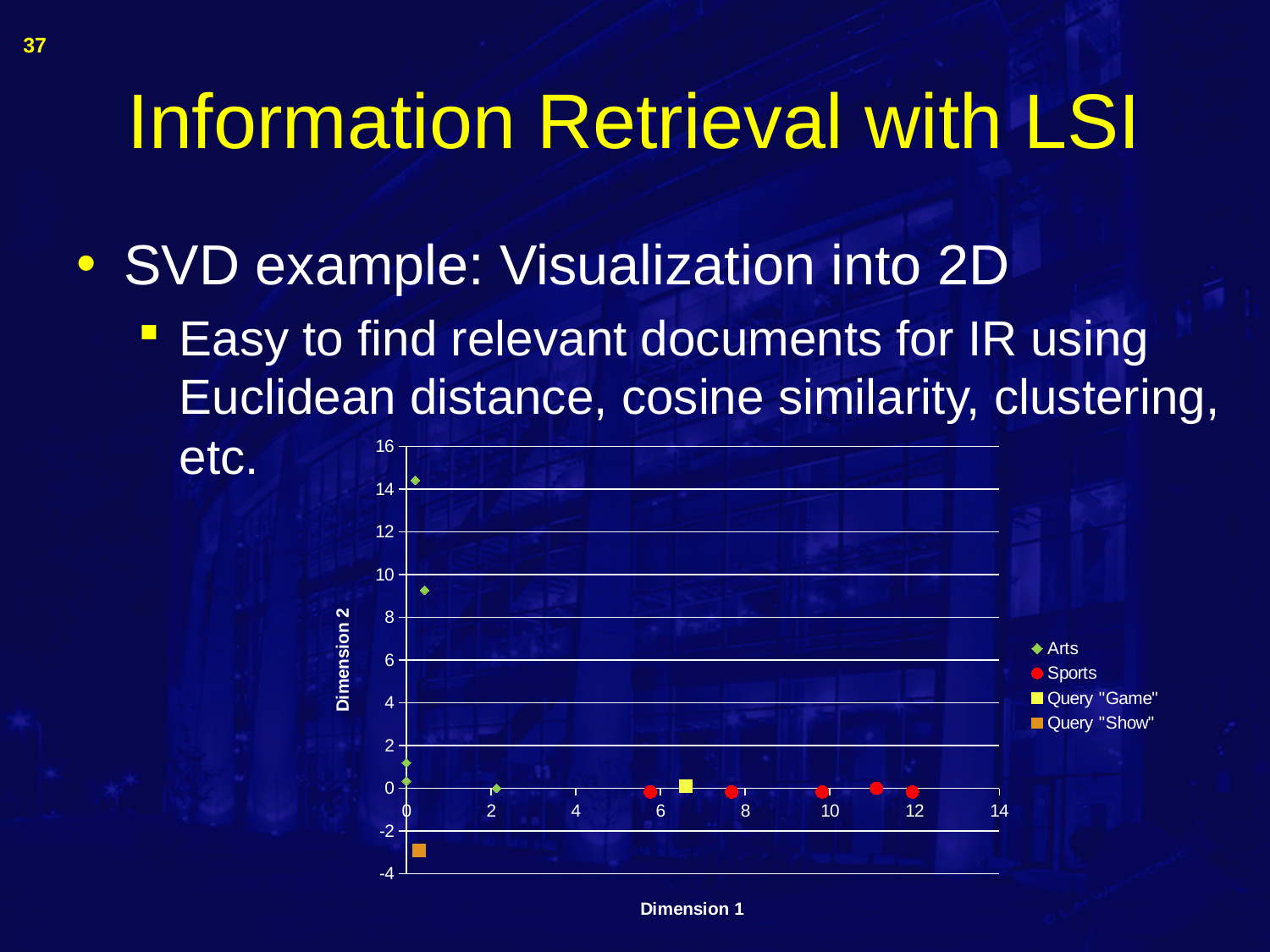
What are the series names listed in the chart's legend? Arts, Sports, Query "Game", Query "Show" Is the Dimension 1 value of the Query "Game" point greater or less than 4? greater Which series contains the point with the lowest Dimension 2 value? Query "Show" What kind of chart is shown on the slide? scatter chart How many Query "Game" points are plotted on the chart? 1 Is the Dimension 2 value of the highest Arts point greater or less than 12? greater How many Sports points are plotted on the chart? 5 Is the Dimension 2 value of the Query "Show" point greater or less than 0? less What is the title of the chart's horizontal axis? Dimension 1 Which series contains the point with the highest Dimension 2 value? Arts Which has the larger Dimension 2 value, the Query "Game" point or the Query "Show" point? Query "Game" How many series does the chart's legend list? 4